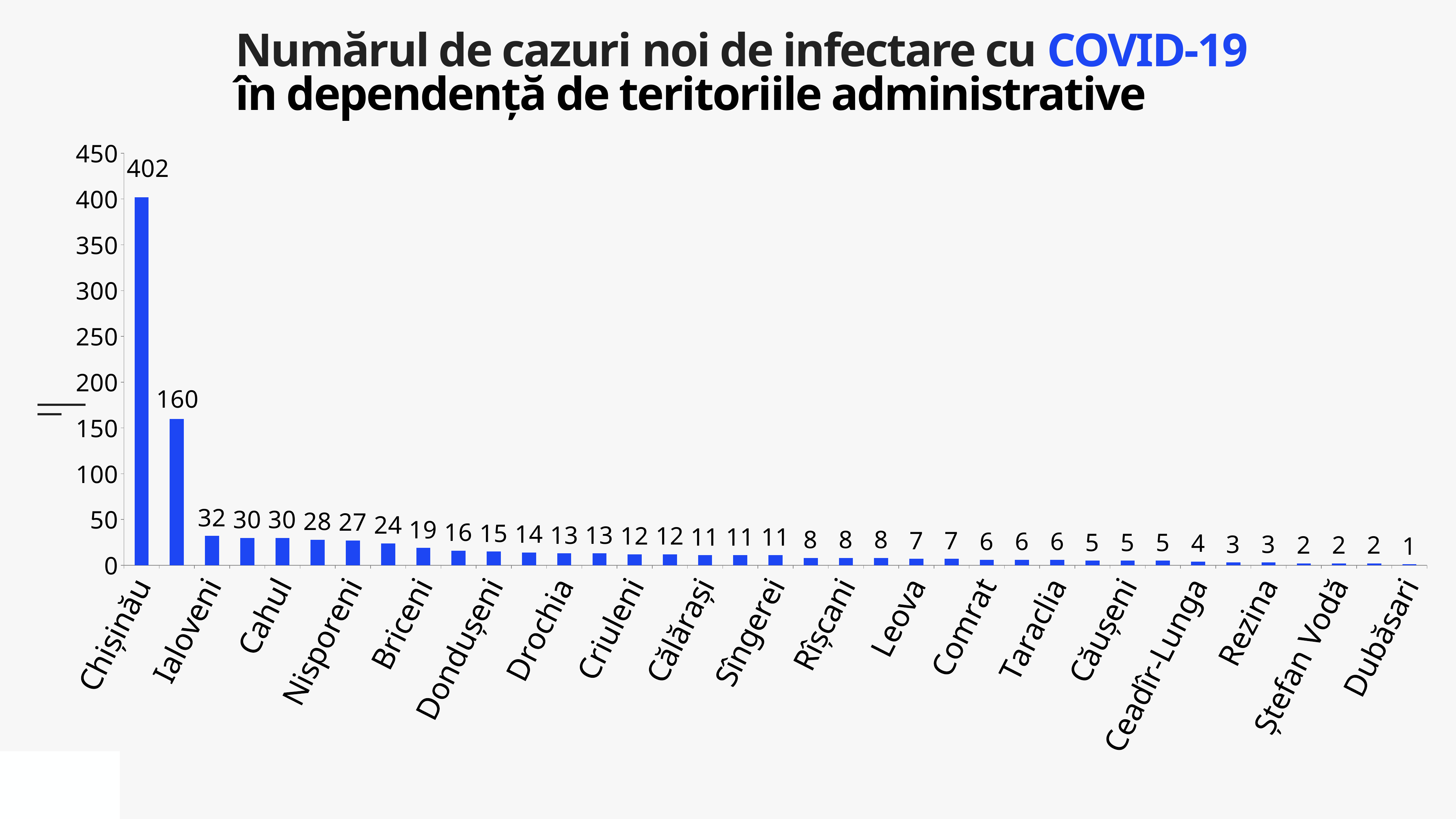
Which territory has the lowest number of new cases? Dubăsari Which is larger, the value for Chișinău or the value for Dubăsari? Chișinău Do the values rise or fall from left to right along the x axis? fall What is the number of new COVID-19 cases for Chișinău? 402 Is the value for Chișinău greater or less than 400? greater What type of chart is shown on the slide? bar chart What is the number of new COVID-19 cases for Dubăsari? 1 How many bars are plotted in the chart? 37 What is the difference between the two tallest bars (402 and 160)? 242 What colour are the bars in the chart? blue Which territory has the highest number of new cases? Chișinău What is the highest value shown on the vertical axis? 450